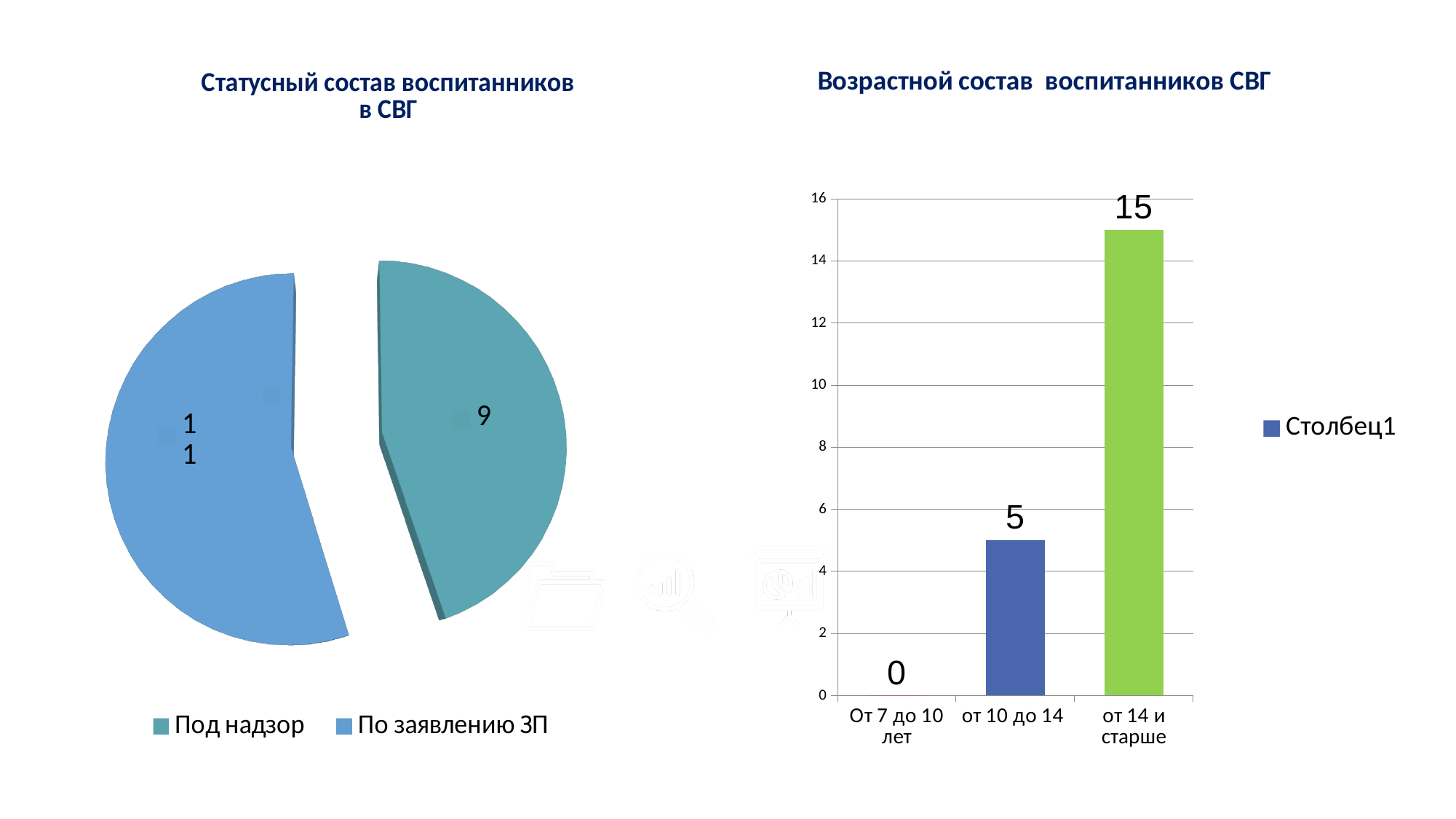
In the bar chart 'Возрастной состав воспитанников СВГ', which category has the lowest value? От 7 до 10 лет What kind of chart is the chart on the right side of the slide? bar chart In the bar chart 'Возрастной состав воспитанников СВГ', what is the value for 'От 7 до 10 лет'? 0 In the bar chart 'Возрастной состав воспитанников СВГ', do the values rise or fall from left to right? rise In the bar chart 'Возрастной состав воспитанников СВГ', what is the value for 'от 10 до 14'? 5 In the bar chart 'Возрастной состав воспитанников СВГ', what is the difference between 'от 14 и старше' and 'от 10 до 14'? 10 In the bar chart 'Возрастной состав воспитанников СВГ', what is the value for 'от 14 и старше'? 15 In the bar chart 'Возрастной состав воспитанников СВГ', how many categories are shown on the x axis? 3 What kind of chart is 'Статусный состав воспитанников в СВГ'? pie chart In the pie chart 'Статусный состав воспитанников в СВГ', what is the value for 'Под надзор'? 9 In the pie chart 'Статусный состав воспитанников в СВГ', which slice is larger, 'Под надзор' or 'По заявлению ЗП'? По заявлению ЗП In the bar chart 'Возрастной состав воспитанников СВГ', which category has the highest value? от 14 и старше